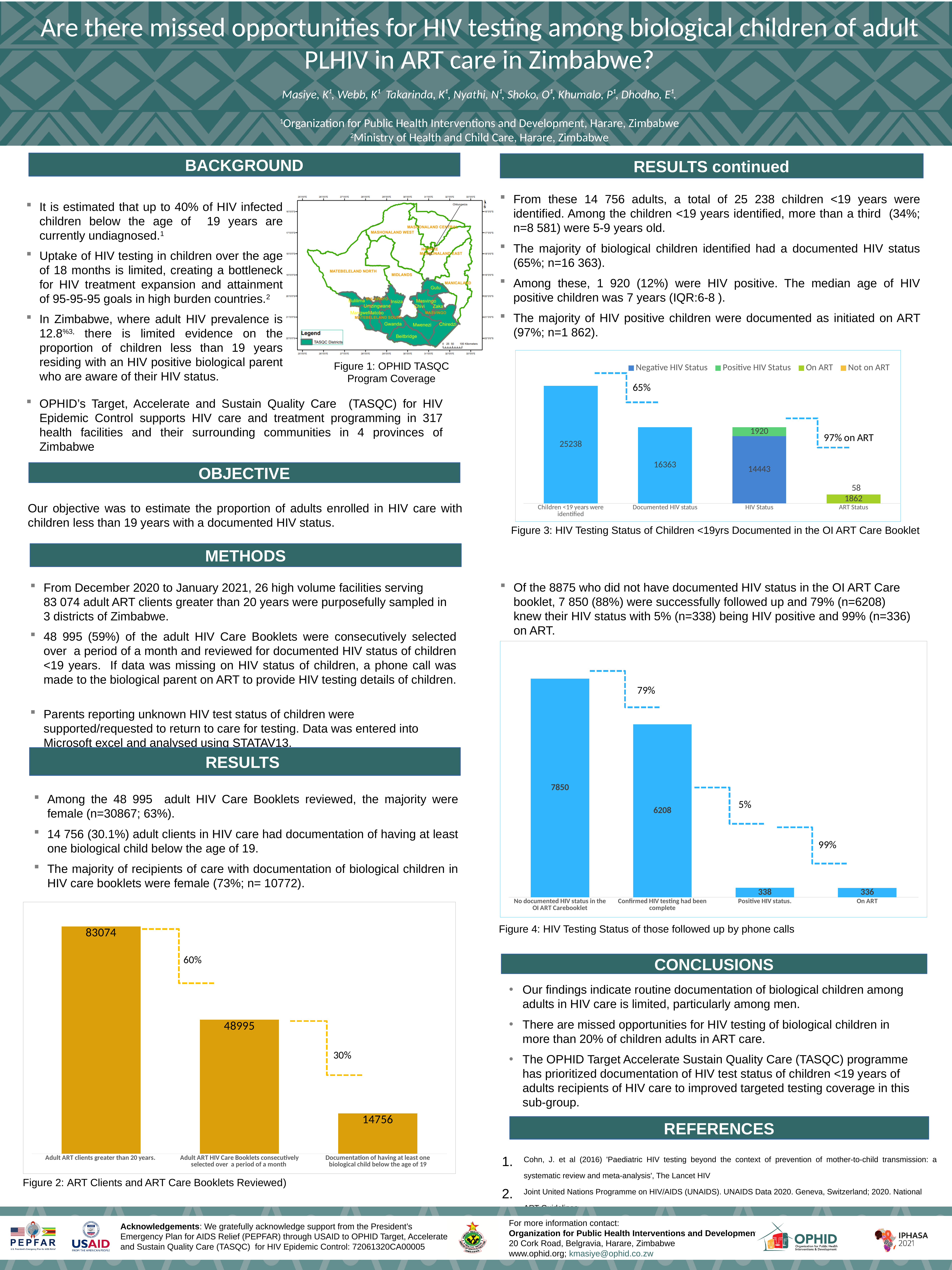
In Figure 4 (HIV Testing Status of those followed up by phone calls), which is larger: 'Positive HIV status' or 'On ART'? Positive HIV status In Figure 3 (HIV Testing Status of Children <19yrs), what percentage annotation is shown next to the 'ART Status' bar? 97% on ART In Figure 3 (HIV Testing Status of Children <19yrs), how many series does the legend list? 4 In Figure 3 (HIV Testing Status of Children <19yrs), what is the Positive HIV Status value in the 'HIV Status' bar? 1920 In Figure 4 (HIV Testing Status of those followed up by phone calls), how many bars are plotted? 4 In Figure 2 (ART Clients and ART Care Booklets Reviewed), what kind of chart is shown? Bar chart In Figure 2 (ART Clients and ART Care Booklets Reviewed), which category has the lowest value? Documentation of having at least one biological child below the age of 19 In Figure 2 (ART Clients and ART Care Booklets Reviewed), what is the value for 'Adult ART clients greater than 20 years'? 83074 In Figure 2 (ART Clients and ART Care Booklets Reviewed), what is the difference between the values for 'Adult ART clients greater than 20 years' and 'Adult ART HIV Care Booklets consecutively selected over a period of a month'? 34079 In Figure 3 (HIV Testing Status of Children <19yrs), what is the value for 'Children <19 years were identified'? 25238 In Figure 4 (HIV Testing Status of those followed up by phone calls), what is the value for 'Confirmed HIV testing had been complete'? 6208 In Figure 3 (HIV Testing Status of Children <19yrs), what is the total of the stacked 'ART Status' bar? 1920